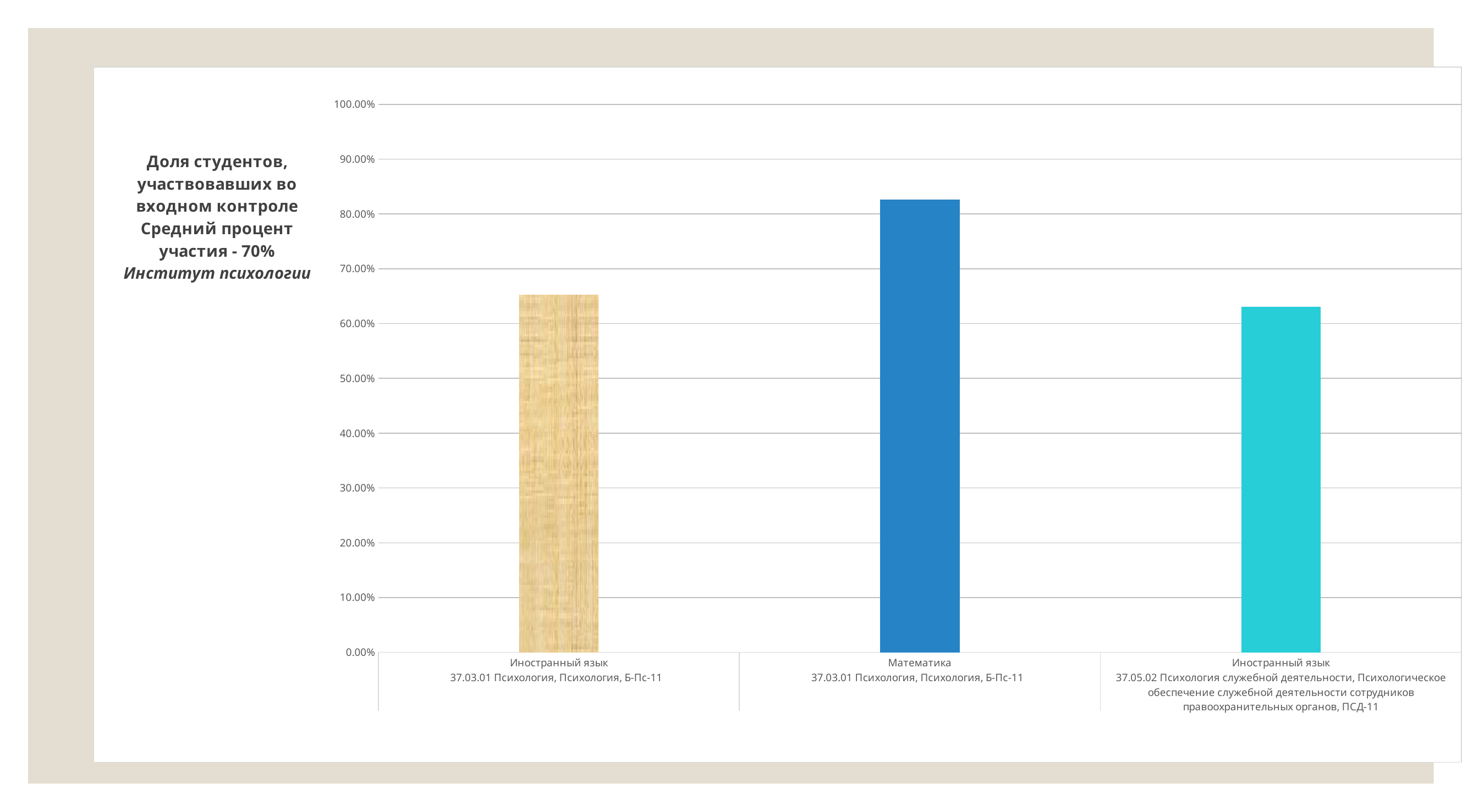
How many bars (categories) does the chart show? 3 Is the value for Иностранный язык (37.05.02 Психология служебной деятельности, ПСД-11) greater or less than 70%? less Is the value for Иностранный язык (37.03.01 Психология, Б-Пс-11) greater or less than 70%? less Which is larger: the value for Математика (Б-Пс-11) or the value for Иностранный язык (Б-Пс-11)? Математика (Б-Пс-11) Which institute is named in the chart's title text? Институт психологии According to the text on the slide, what is the average participation percentage (Средний процент участия)? 70% Which category has the highest value? Математика (37.03.01 Психология, Психология, Б-Пс-11) Is the value for Иностранный язык (37.05.02 Психология служебной деятельности, ПСД-11) greater or less than 60%? greater What kind of chart is shown on the slide? bar chart